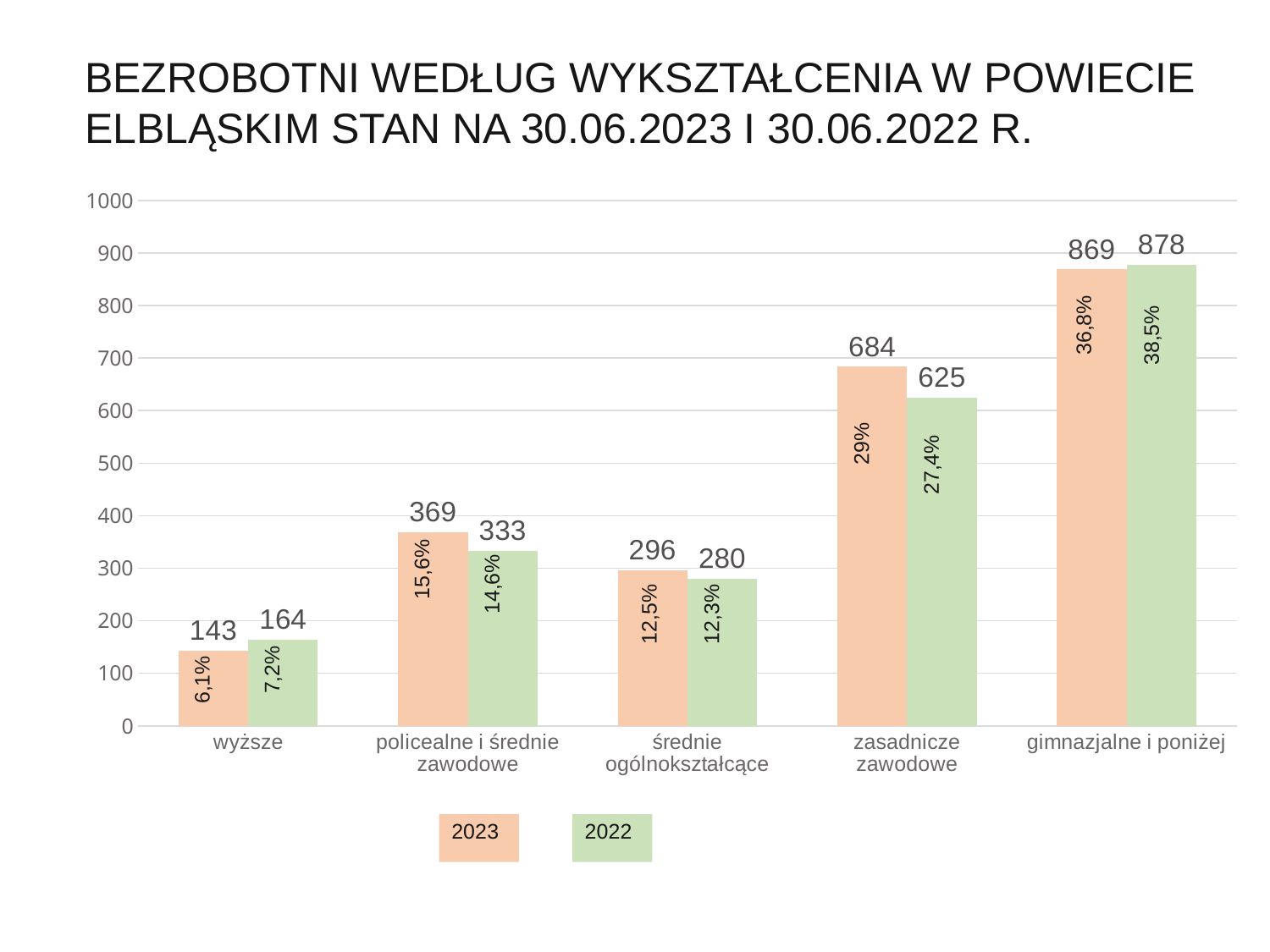
Which category has the lowest value in 2022? wyższe What kind of chart is shown on the slide? bar chart How many education categories are shown on the x axis? 5 What is the difference between the 2022 and 2023 values for 'wyższe'? 21 What is the value for 'zasadnicze zawodowe' in 2022? 625 Which category has the highest value in 2023? gimnazjalne i poniżej Which is larger for 'zasadnicze zawodowe': the 2023 value or the 2022 value? 2023 What is the difference between the 2023 and 2022 values for 'policealne i średnie zawodowe'? 36 Which colour represents the 2022 series? green How many series does the legend list? 2 What is the value for 'wyższe' in 2023? 143 What percentage label is shown on the 2023 bar for 'gimnazjalne i poniżej'? 36,8%